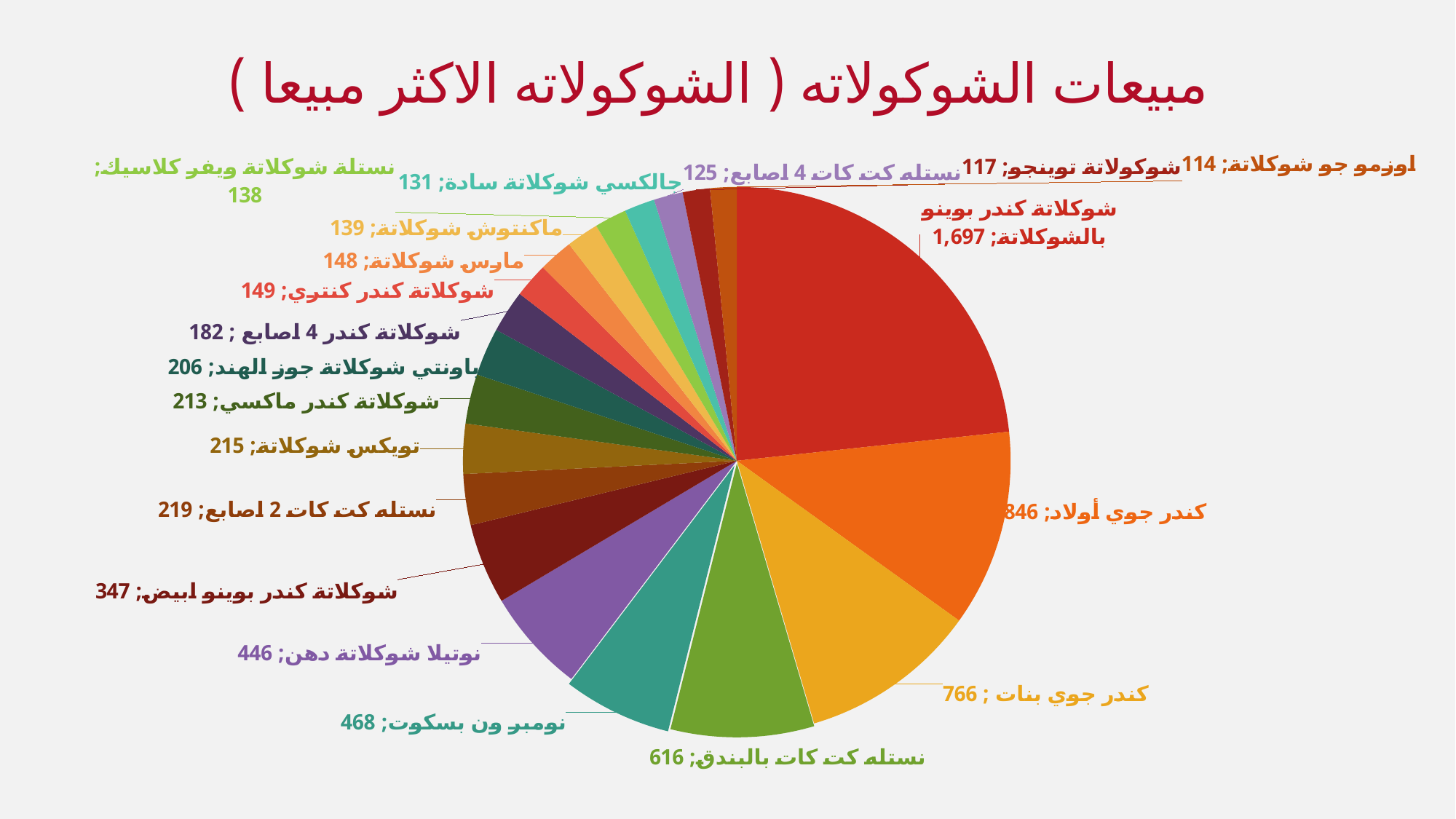
Which category has the largest slice? شوكلاتة كندر بوينو بالشوكلاتة What is the value for شوكولاتة كندر بوينو بالشوكلاتة? 1,697 Which category has the smallest slice? اوزمو جو شوكلاتة What is the value for نوتيلا شوكلاتة دهن? 446 What is the difference between the values for كندر جوي أولاد and كندر جوي بنات? 80 What is the title of the chart? مبيعات الشوكولاته ( الشوكولاته الاكثر مبيعا ) How many slices does the pie chart have? 20 What is the difference between the values for شوكولاتة كندر بوينو بالشوكلاتة and كندر جوي أولاد? 851 What is the value for نستله كت كات بالبندق? 616 What is the value for كندر جوي أولاد? 846 What type of chart is shown on the slide? pie chart Which is larger, نومبر ون بسكوت or نوتيلا شوكلاتة دهن? نومبر ون بسكوت